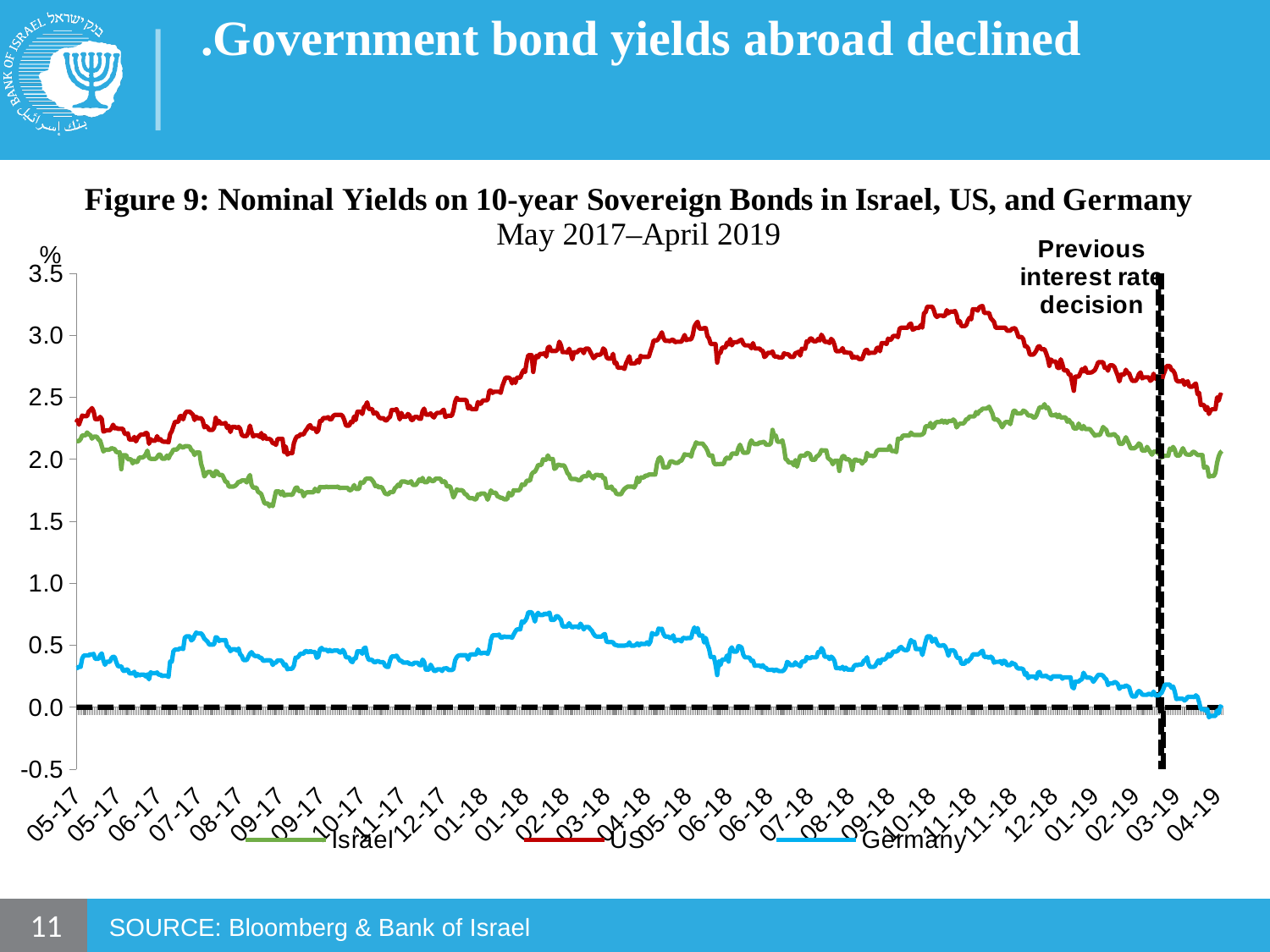
How many series does the legend list? 3 Which countries are listed in the legend? Israel, US, Germany Is the Germany yield at the end of the period (04-19) greater or less than 0.5? less Which series has the highest yields throughout the period shown? US What does the vertical dashed line near 03-19 mark? Previous interest rate decision Which series has the lowest yields throughout the period shown? Germany Do the US yields rise or fall from 11-18 to 04-19? fall Is the Israel yield around 09-17 greater or less than 2.0? less Is the US yield at its peak around 11-18 greater or less than 3.0? greater Which is larger in 06-18, the US yield or the Germany yield? US What kind of chart is shown on the slide? Line chart